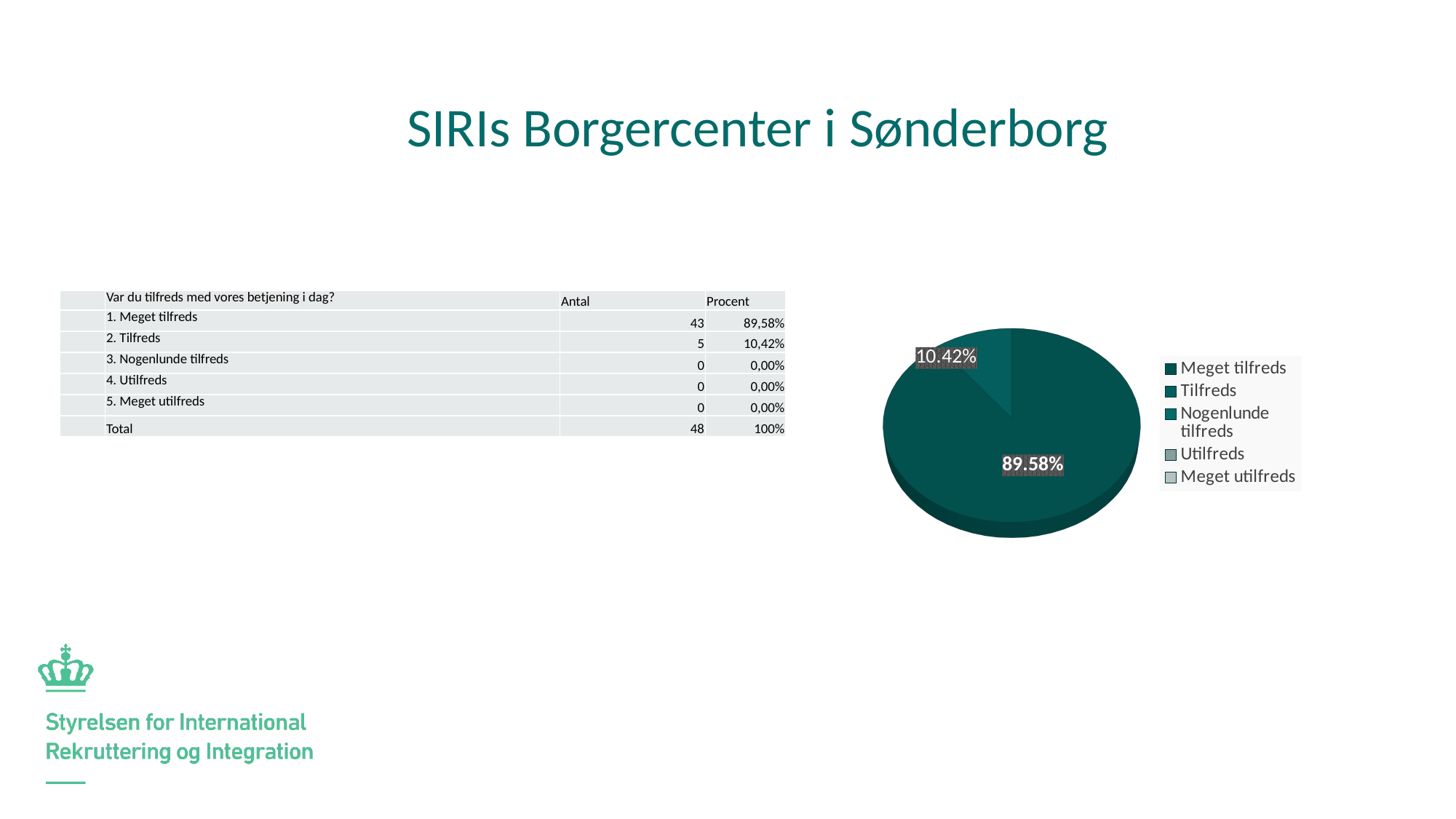
What share of the pie does Meget tilfreds have? 89.58% Which category has the largest slice of the pie? Meget tilfreds Is the share for Meget tilfreds greater or less than 50%? greater How many slices of the pie have a data label shown? 2 What share of the pie does Tilfreds have? 10.42% What kind of chart is shown on the slide? pie chart How many entries does the legend list? 5 Which is larger, the slice for Meget tilfreds or the slice for Tilfreds? Meget tilfreds What is the difference in percentage points between the Meget tilfreds slice and the Tilfreds slice? 79.16 What is the last entry listed in the legend? Meget utilfreds What is the title of the slide containing the pie chart? SIRIs Borgercenter i Sønderborg